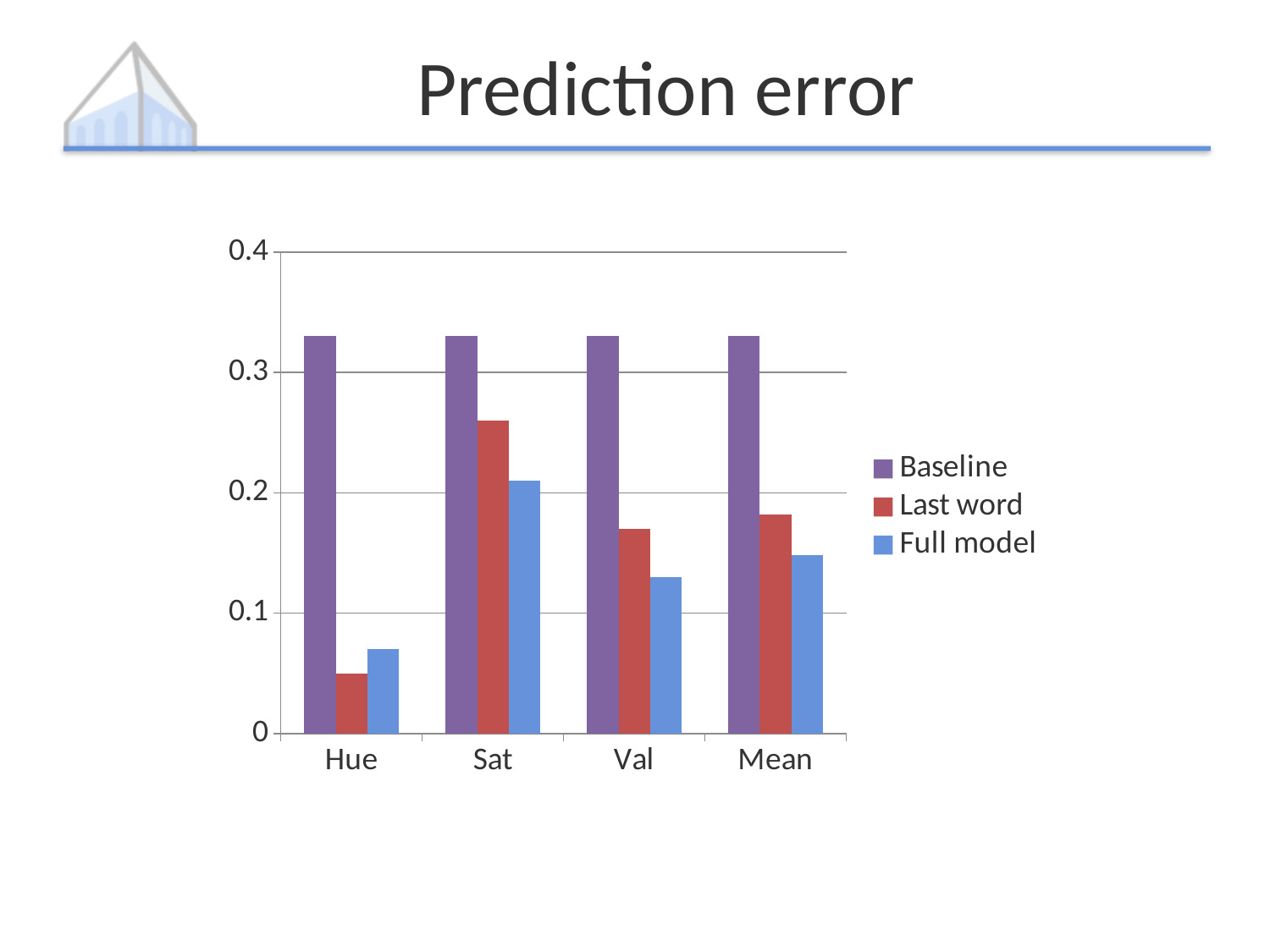
Is the Last word value for Mean greater or less than 0.2? less What kind of chart is shown on the slide? bar chart Is the Baseline value for Hue greater or less than 0.3? greater What is the title of the slide containing the chart? Prediction error Which is larger for the Full model series, the value for Sat or the value for Val? Sat Which series has the lowest value for Sat? Full model Is the Last word value for Hue greater or less than 0.1? less How many series does the legend list? 3 Which series is shown in blue in the legend? Full model How many categories are shown on the x axis? 4